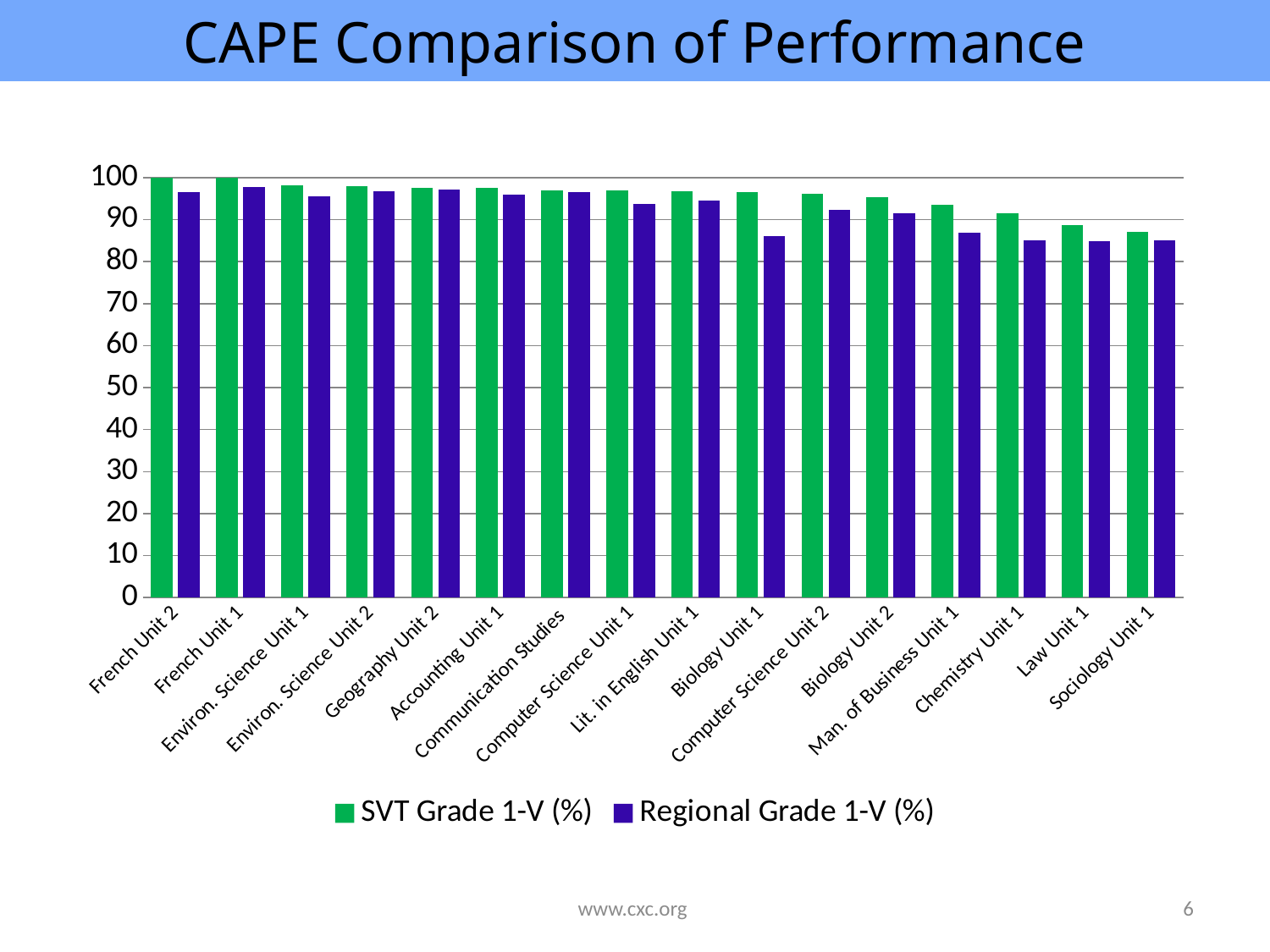
Do the SVT Grade 1-V (%) values generally rise or fall moving from left to right along the x axis? fall Is the SVT Grade 1-V (%) value for Law Unit 1 greater or less than 90? less How many series does the legend list? 2 Which colour represents the SVT Grade 1-V (%) series? green Is the Regional Grade 1-V (%) value for Chemistry Unit 1 greater or less than 80? greater What is the SVT Grade 1-V (%) value for French Unit 2? 100 What kind of chart is shown on the slide? bar chart Is the Regional Grade 1-V (%) value for Biology Unit 1 greater or less than 90? less For Biology Unit 1, which is larger: the SVT Grade 1-V (%) value or the Regional Grade 1-V (%) value? SVT Grade 1-V (%) What is the SVT Grade 1-V (%) value for French Unit 1? 100 What is the title of the chart? CAPE Comparison of Performance How many subject categories are shown on the x axis? 16